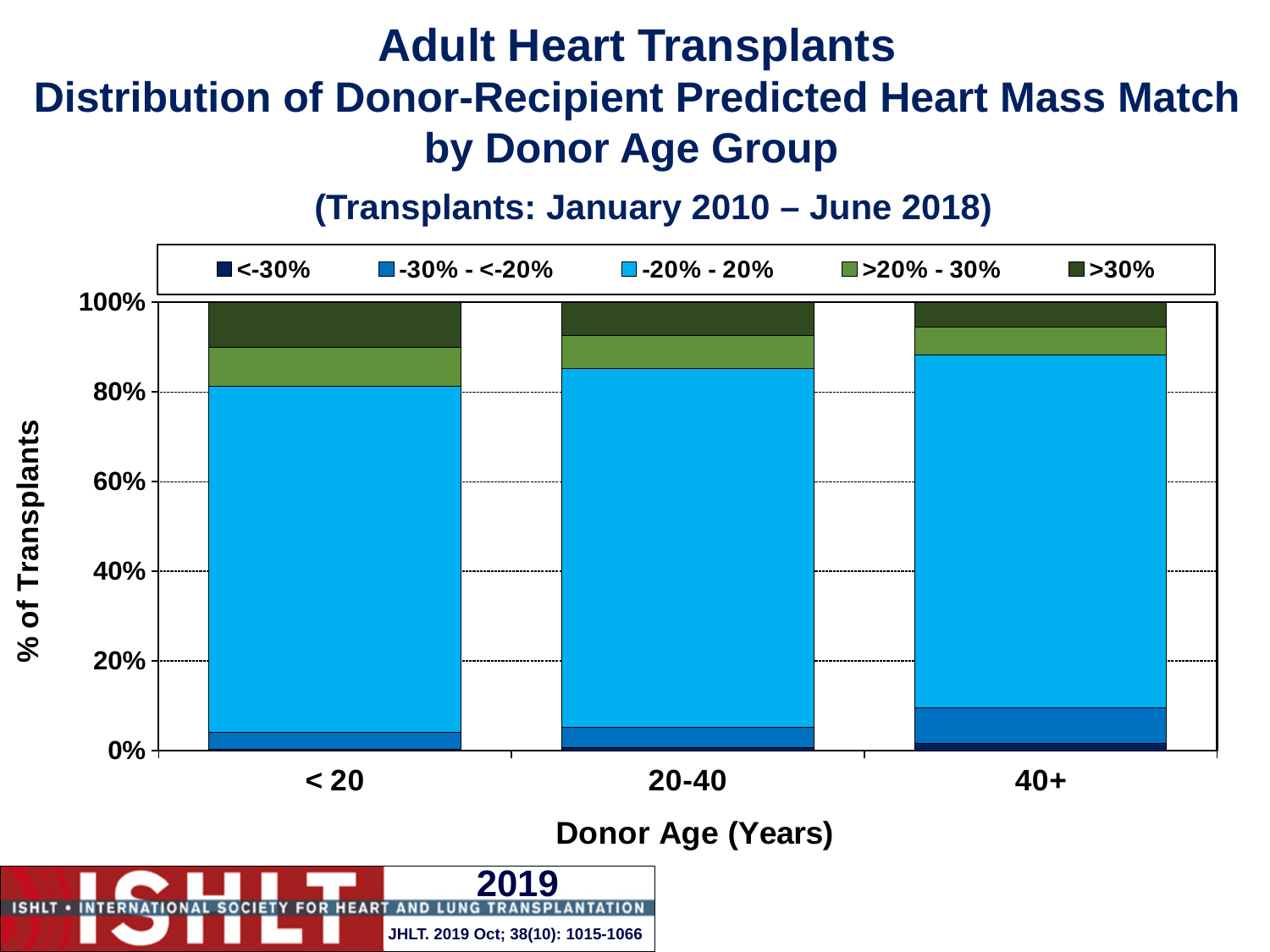
Which is larger, the >30% share for the < 20 group or for the 40+ group? < 20 What kind of chart is shown on the slide? Stacked bar chart How many donor age groups are shown on the x axis? 3 Is the -30% - <-20% share for the 40+ donor age group greater or less than 20%? less What is the label of the y axis? % of Transplants Which donor age group has the largest >30% share? < 20 How many series does the legend list? 5 Which donor age group has the largest -30% - <-20% share? 40+ What is the label of the x axis? Donor Age (Years)